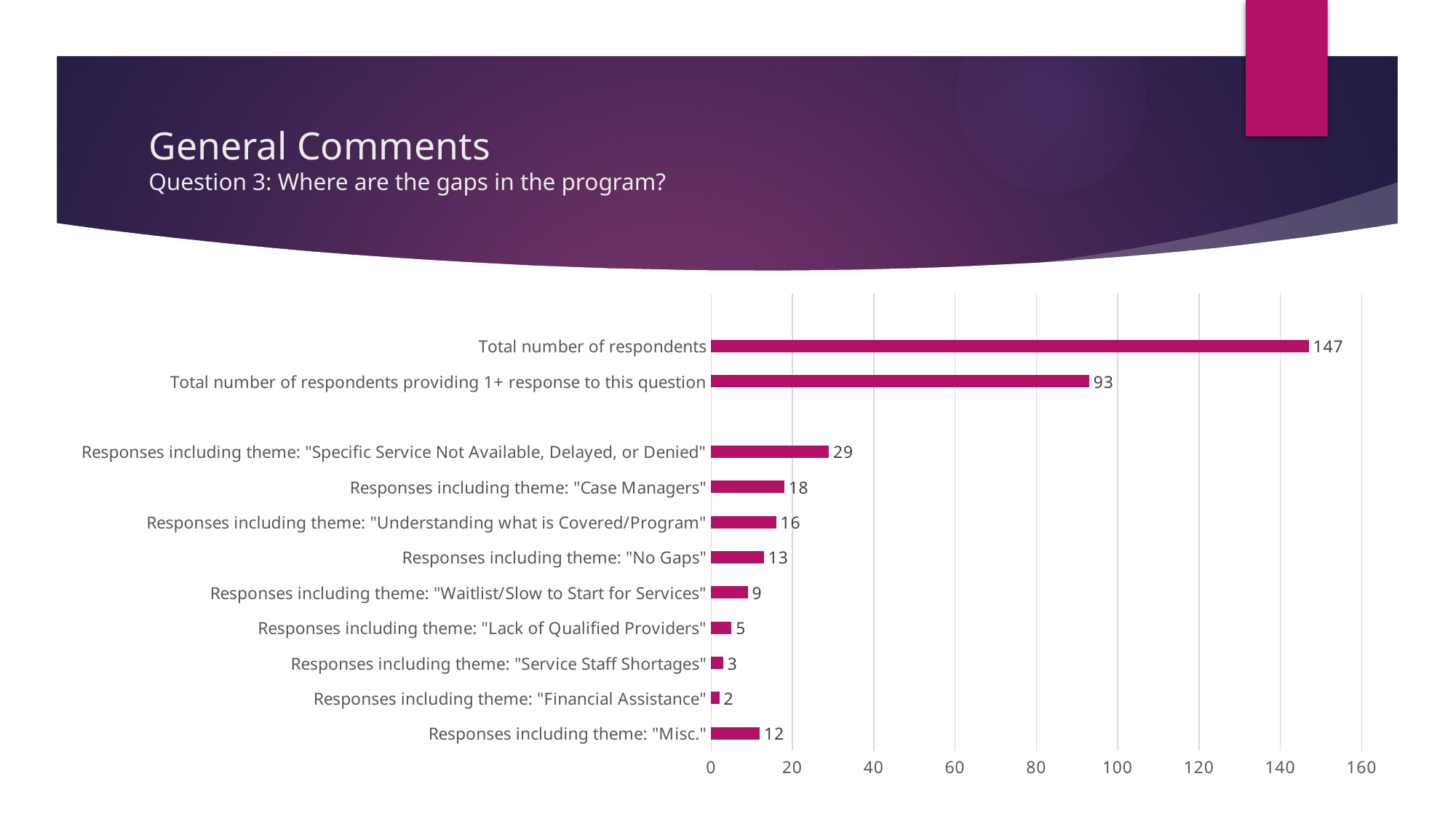
What is the value for responses including theme "Misc."? 12 How many respondents provided 1+ response to this question? 93 Which category has the lowest value on the chart? Responses including theme: "Financial Assistance" What is the value for responses including theme "Case Managers"? 18 Is the value for "Total number of respondents providing 1+ response to this question" greater or less than 100? less Which is larger: "Understanding what is Covered/Program" or "Misc."? Understanding what is Covered/Program Which theme category has the highest number of responses? Specific Service Not Available, Delayed, or Denied What is the difference between "Total number of respondents" and "Total number of respondents providing 1+ response to this question"? 54 What is the difference between the "No Gaps" theme and the "Waitlist/Slow to Start for Services" theme? 4 What is the value for "Total number of respondents"? 147 What kind of chart is shown on the slide? Bar chart How many categories are plotted on the chart? 11